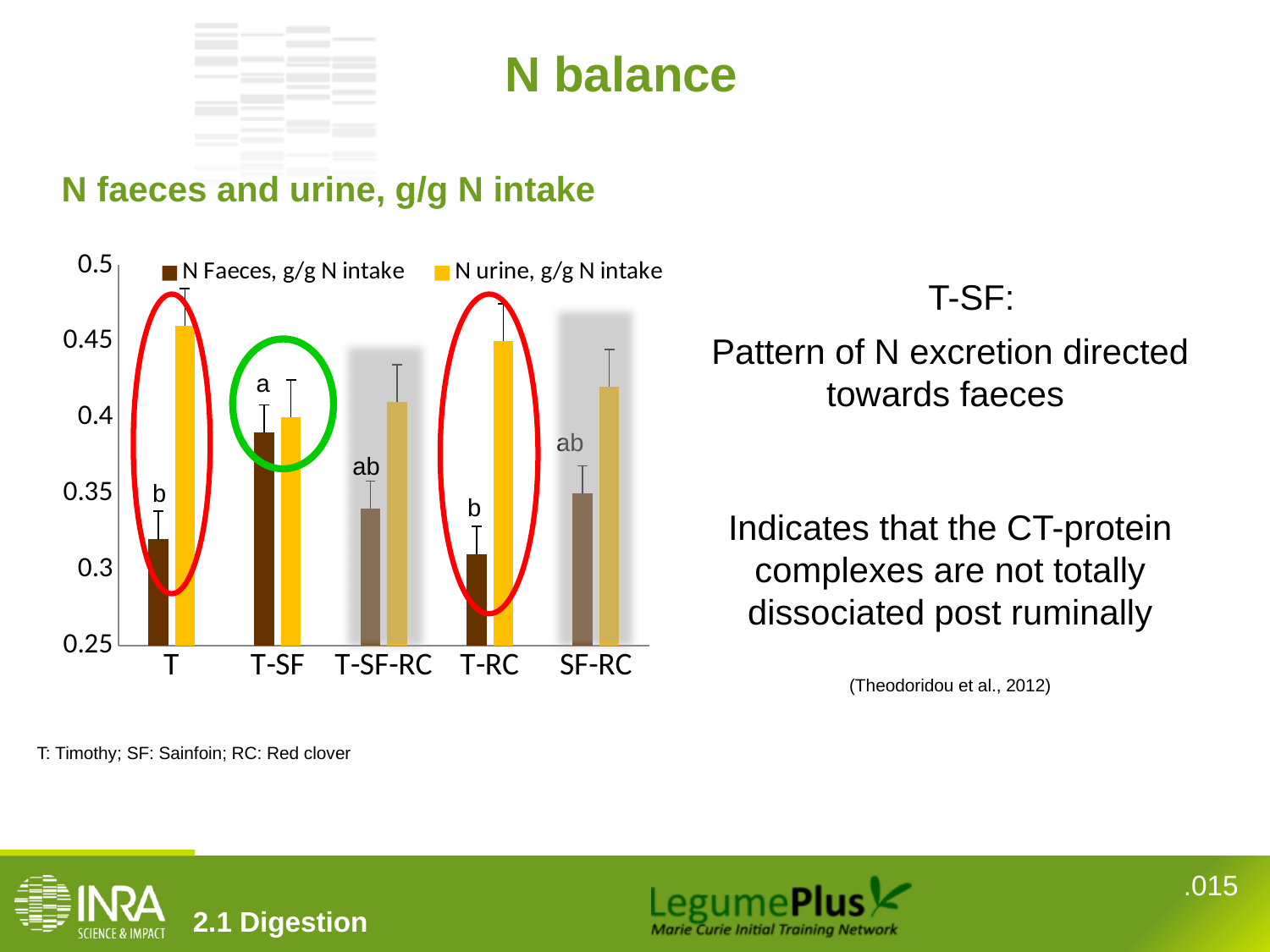
Is the N Faeces, g/g N intake value for T-SF greater or less than 0.35? greater Is the N urine, g/g N intake value for T-RC greater or less than 0.4? greater Which is larger: the N Faeces value for T-SF or the N Faeces value for T-SF-RC? T-SF What letter label is printed above the N Faeces bar for T-SF? a For the T category, which is larger: N Faeces or N urine (g/g N intake)? N urine Is the N urine, g/g N intake value for T greater or less than 0.4? greater Which category has the highest value for N Faeces, g/g N intake? T-SF How many series does the chart legend list? 2 How many diet categories are shown on the x axis of the chart? 5 What kind of chart is shown on the slide? bar chart